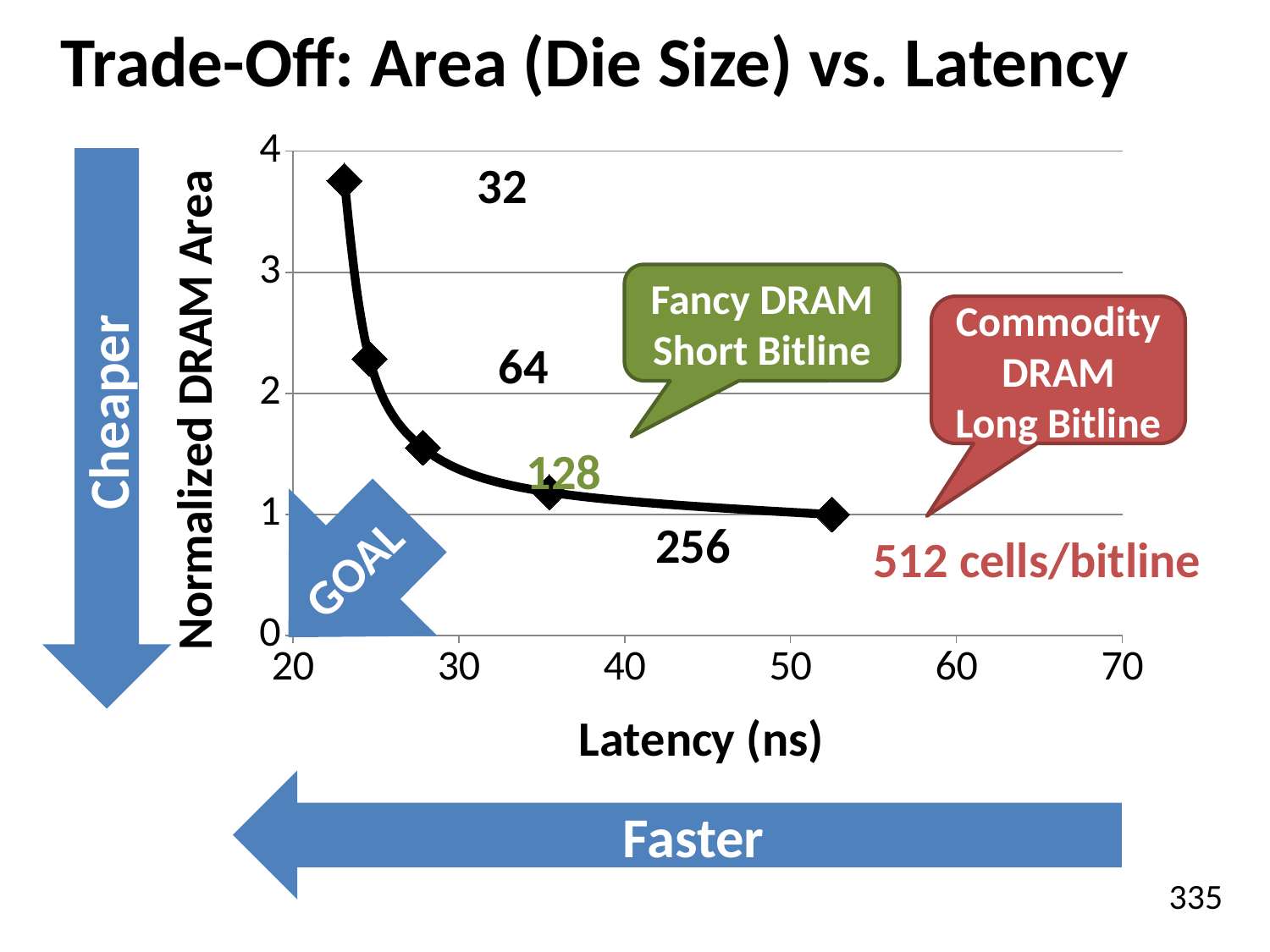
Is the latency for the 512 cells/bitline point greater or less than 50 ns? greater What kind of chart is shown on the slide? line chart Which labeled point has the highest normalized DRAM area? 32 What is the label of the x axis? Latency (ns) Is the normalized DRAM area for the 128 cells/bitline point greater or less than 2? less Which has a larger normalized DRAM area, the 64 cells/bitline point or the 256 cells/bitline point? 64 cells/bitline Which labeled point has the lowest normalized DRAM area? 512 cells/bitline Is the normalized DRAM area for the 32 cells/bitline point greater or less than 3? greater How many data points are plotted on the curve? 5 What is the title of the slide's chart? Trade-Off: Area (Die Size) vs. Latency As latency increases along the x axis, does the normalized DRAM area rise or fall? fall